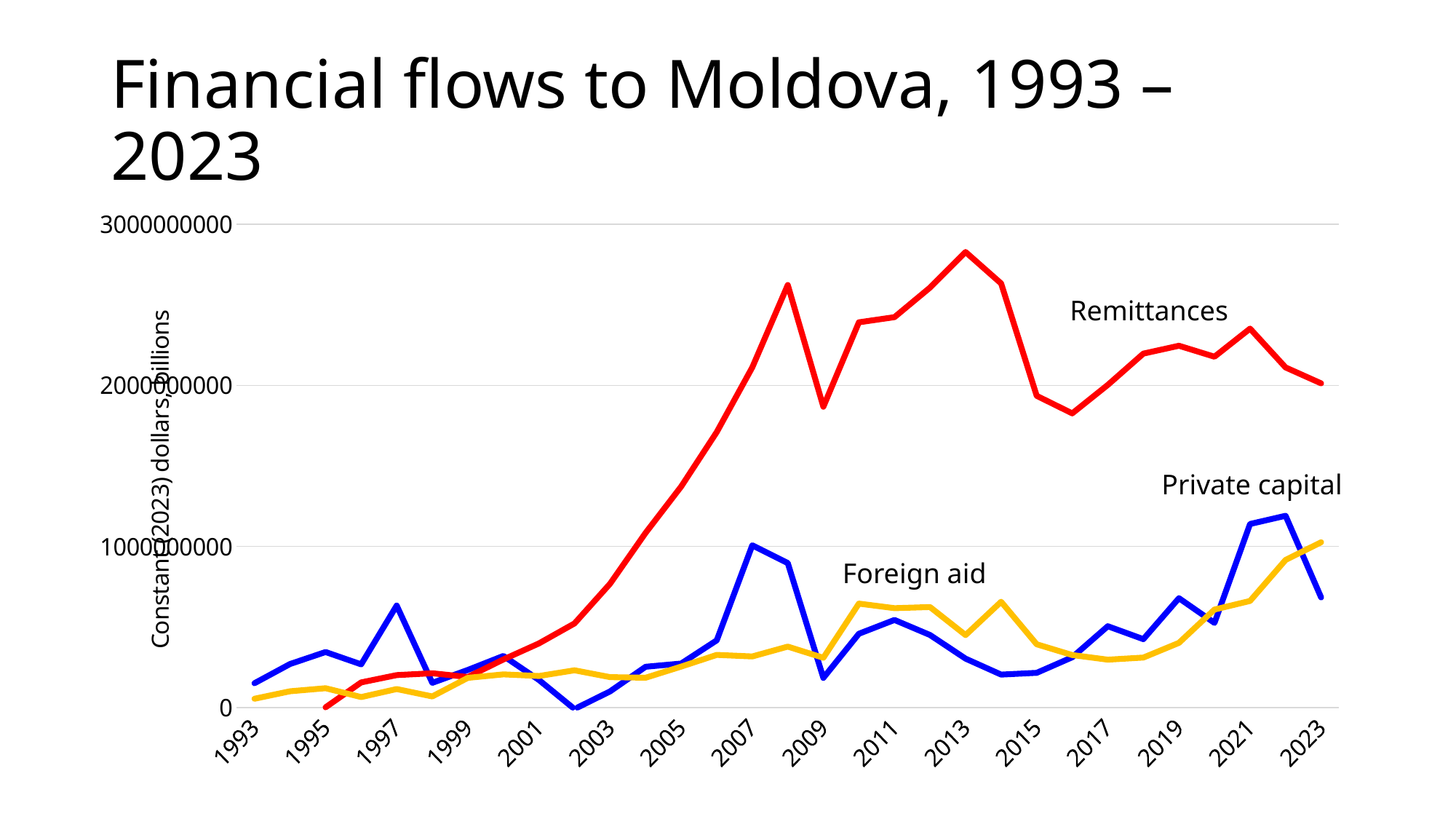
What is the label on the vertical axis of the chart? Constant (2023) dollars, billions Is the value for Remittances in 2009 greater or less than 2000000000? less Is the value for Remittances in 2005 greater or less than 1000000000? greater Which series has the lowest value in 2023? Private capital In 2023, which is larger: Foreign aid or Private capital? Foreign aid Do Remittances rise or fall between 2003 and 2008? rise What type of chart is shown on the slide? line chart How many data series are plotted on the chart? 3 Is the value for Remittances in 2013 greater or less than 2000000000? greater Do Remittances rise or fall between 2013 and 2016? fall Which series reaches the highest value on the chart? Remittances